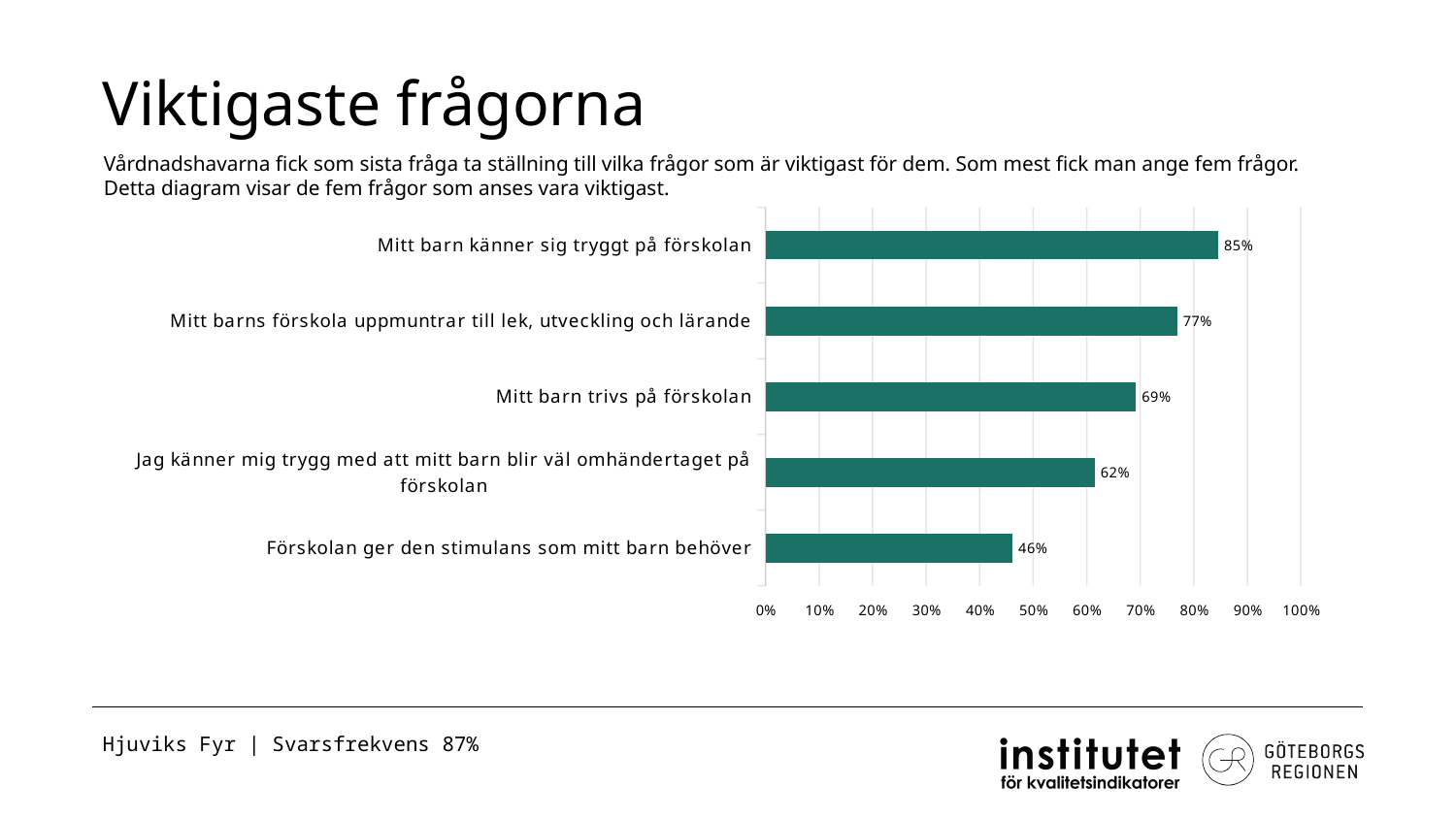
How many categories are shown in the chart? 5 What is the value for "Mitt barn känner sig tryggt på förskolan"? 85% Which category has the highest value? Mitt barn känner sig tryggt på förskolan What kind of chart is shown on the slide? Bar chart What is the value for "Mitt barn trivs på förskolan"? 69% What is the value for "Förskolan ger den stimulans som mitt barn behöver"? 46% Which is larger: the value for "Mitt barn trivs på förskolan" or the value for "Förskolan ger den stimulans som mitt barn behöver"? Mitt barn trivs på förskolan What is the title of the slide containing the chart? Viktigaste frågorna What is the value for "Jag känner mig trygg med att mitt barn blir väl omhändertaget på förskolan"? 62% What is the difference between the values for "Mitt barn känner sig tryggt på förskolan" and "Mitt barns förskola uppmuntrar till lek, utveckling och lärande"? 8% Which category has the lowest value? Förskolan ger den stimulans som mitt barn behöver Is the value for "Mitt barns förskola uppmuntrar till lek, utveckling och lärande" greater or less than 70%? greater